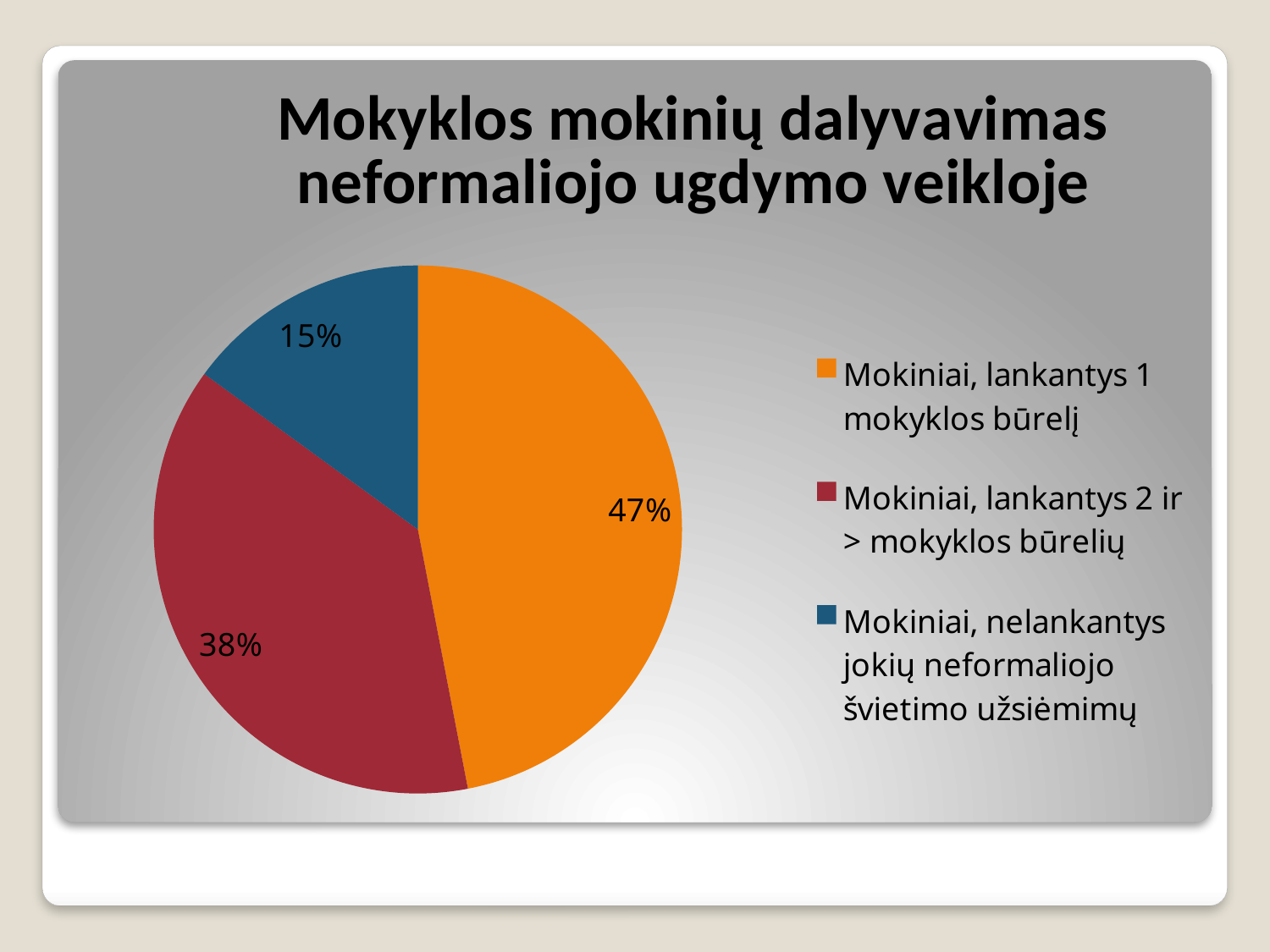
What is the title of the chart on the slide? Mokyklos mokinių dalyvavimas neformaliojo ugdymo veikloje What share of the pie is labelled for 'Mokiniai, lankantys 1 mokyklos būrelį'? 47% What kind of chart is shown on the slide? pie chart Which category has the smallest slice of the pie? Mokiniai, nelankantys jokių neformaliojo švietimo užsiėmimų How many slices does the pie chart have? 3 What is the difference in percentage points between the slice for 'Mokiniai, lankantys 2 ir > mokyklos būrelių' and the slice for 'Mokiniai, nelankantys jokių neformaliojo švietimo užsiėmimų'? 23 What share of the pie is labelled for 'Mokiniai, lankantys 2 ir > mokyklos būrelių'? 38% Which is larger: the slice for 'Mokiniai, lankantys 2 ir > mokyklos būrelių' or the slice for 'Mokiniai, nelankantys jokių neformaliojo švietimo užsiėmimų'? Mokiniai, lankantys 2 ir > mokyklos būrelių What share of the pie is labelled for 'Mokiniai, nelankantys jokių neformaliojo švietimo užsiėmimų'? 15% Which category has the largest slice of the pie? Mokiniai, lankantys 1 mokyklos būrelį What is the difference in percentage points between the slice for 'Mokiniai, lankantys 1 mokyklos būrelį' and the slice for 'Mokiniai, lankantys 2 ir > mokyklos būrelių'? 9 What colour is the slice for 'Mokiniai, nelankantys jokių neformaliojo švietimo užsiėmimų'? blue